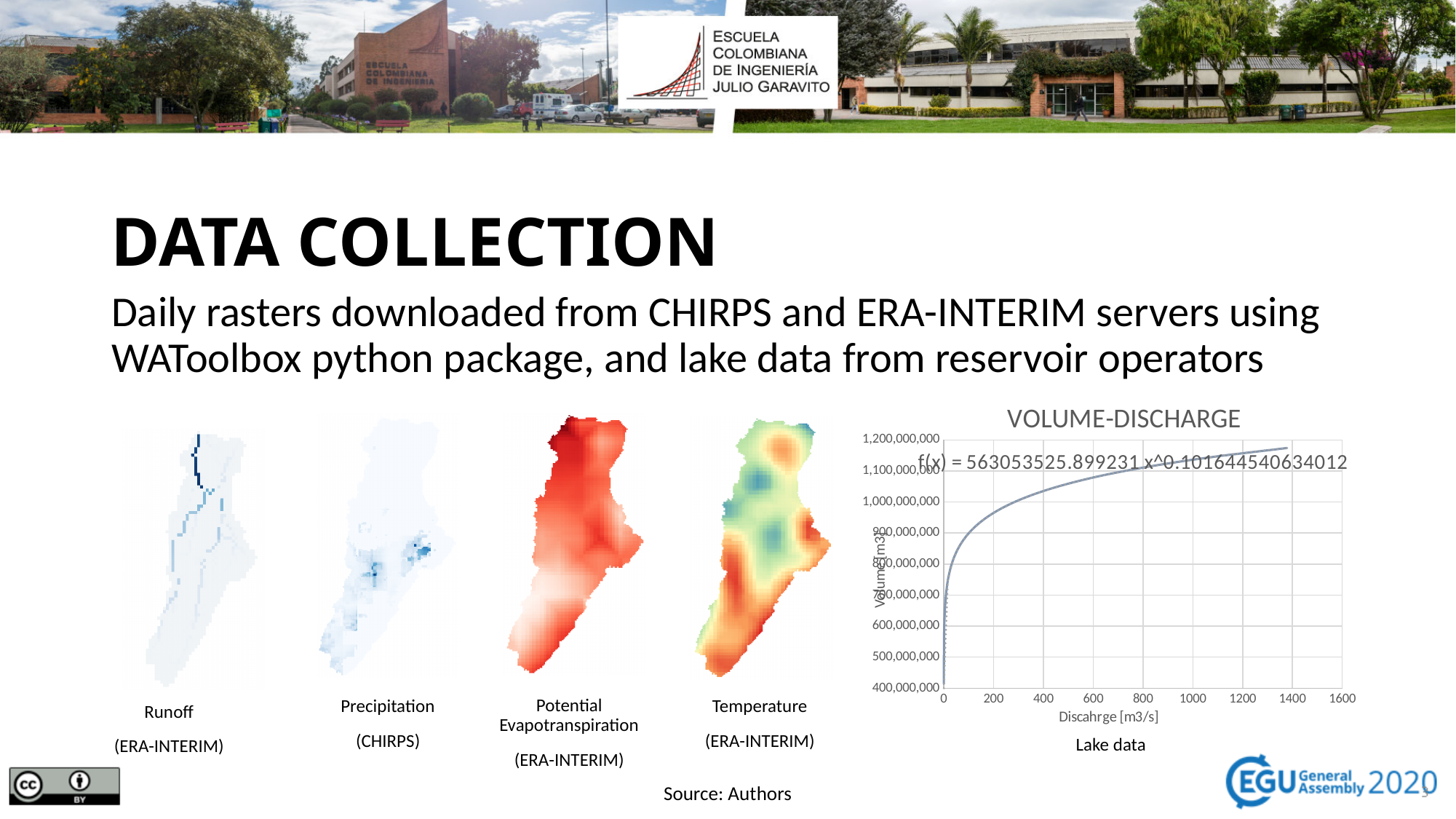
How many tick labels are shown on the x axis of the VOLUME-DISCHARGE chart? 9 What fitted equation is printed on the VOLUME-DISCHARGE chart? f(x) = 563053525.899231 x^0.101644540634012 What kind of chart is the VOLUME-DISCHARGE chart? scatter chart In the VOLUME-DISCHARGE chart, is the volume at a discharge of 200 m3/s greater or less than 900,000,000? greater In the VOLUME-DISCHARGE chart, is the volume at a discharge of 1400 m3/s greater or less than 1,100,000,000? greater What is the highest value shown on the y axis of the VOLUME-DISCHARGE chart? 1,200,000,000 What is the lowest value shown on the y axis of the VOLUME-DISCHARGE chart? 400,000,000 In the VOLUME-DISCHARGE chart, is the volume at a discharge of 600 m3/s greater or less than 1,000,000,000? greater What is the title of the chart on the slide? VOLUME-DISCHARGE What is the highest value shown on the x axis of the VOLUME-DISCHARGE chart? 1600 In the VOLUME-DISCHARGE chart, does the volume rise or fall as discharge increases along the x axis? rise What is the label of the x axis in the VOLUME-DISCHARGE chart? Discahrge [m3/s]